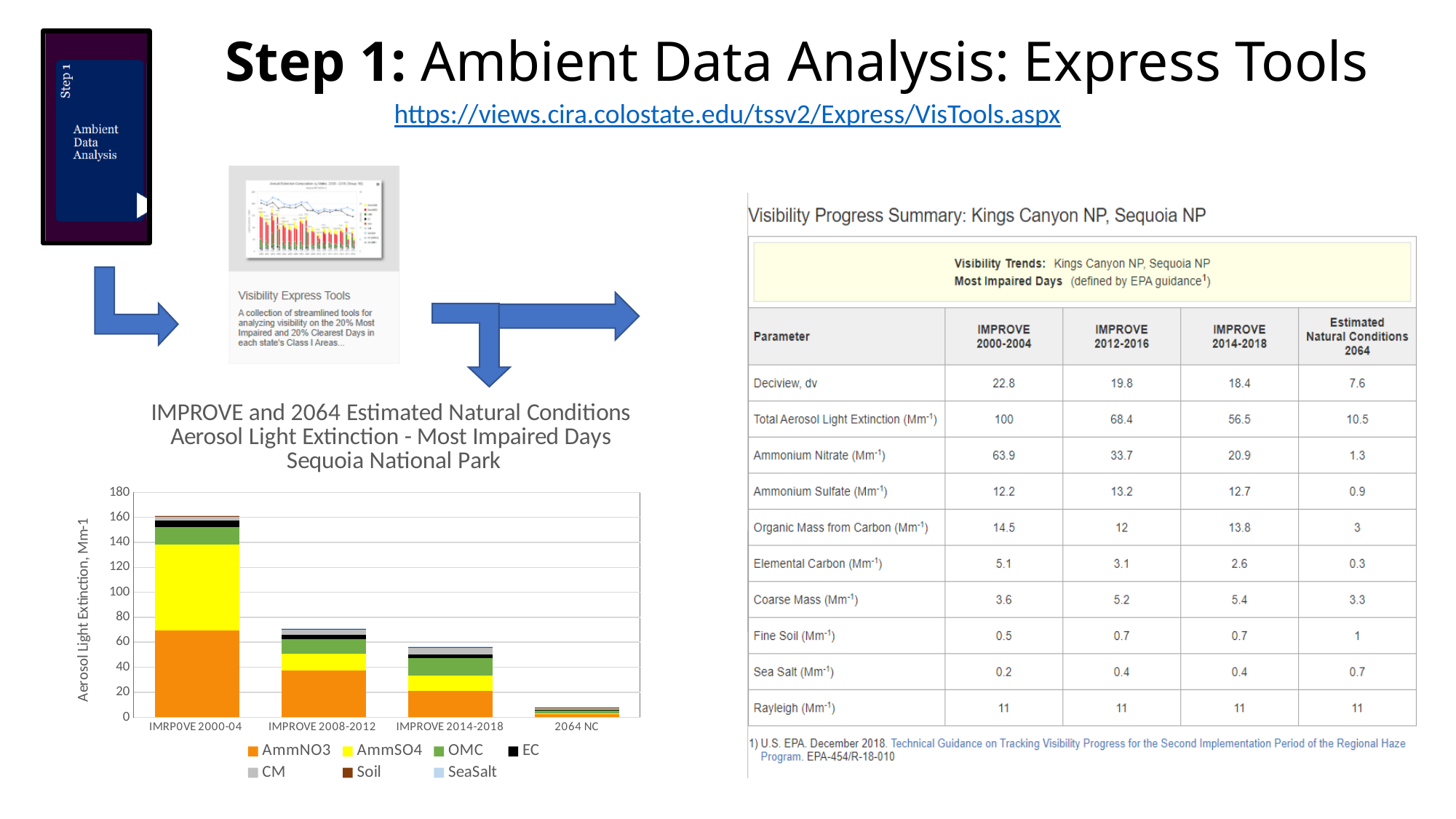
How many series does the chart's legend list? 7 Is the total stacked value for 2064 NC greater or less than 20? less Is the total stacked value for IMRP0VE 2000-04 greater or less than 140? greater Which has the taller stacked bar, IMPROVE 2008-2012 or IMPROVE 2014-2018? IMPROVE 2008-2012 Do the total bar heights rise or fall moving left to right along the x axis? Fall How many bars (categories) are plotted on the x axis of the chart? 4 Which category has the shortest stacked bar in the chart? 2064 NC Is the total stacked value for IMPROVE 2014-2018 greater or less than 60? less Which category has the tallest stacked bar in the chart? IMRP0VE 2000-04 What is the label on the chart's y axis? Aerosol Light Extinction, Mm-1 What kind of chart is shown on the slide? Stacked bar chart What colour represents AmmNO3 in the chart's legend? Orange